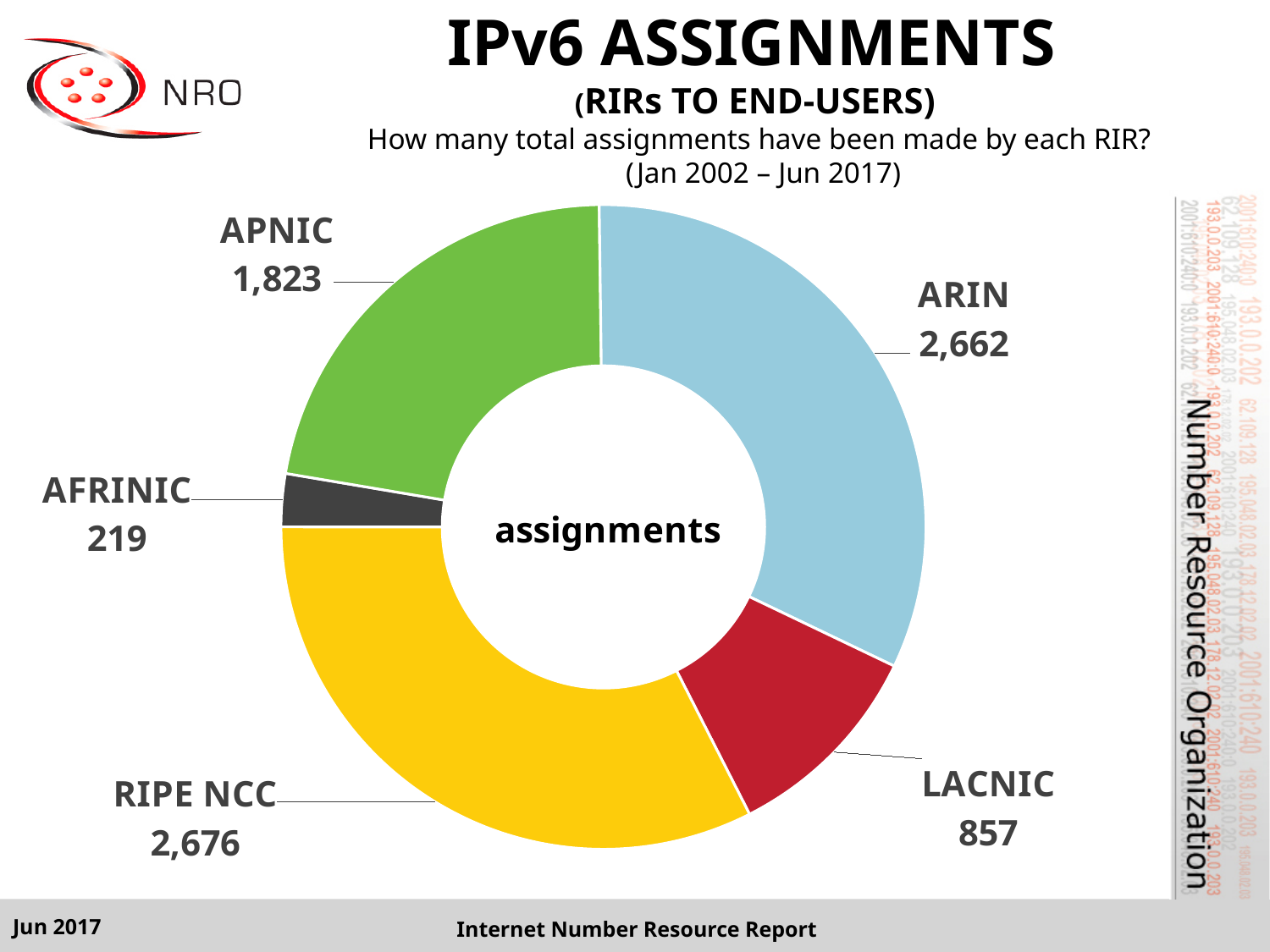
Which has more assignments, APNIC or LACNIC? APNIC How many IPv6 assignments has ARIN made according to the chart? 2,662 What is the difference between the assignments of ARIN and LACNIC? 1,805 How many assignments are shown for AFRINIC? 219 How many RIRs are shown as slices in the chart? 5 Which RIR has the fewest assignments in the chart? AFRINIC What is the value shown for APNIC? 1,823 What is the number of assignments shown for LACNIC? 857 What kind of chart is used on this slide? doughnut chart Which RIR has the most assignments in the chart? RIPE NCC What is the difference between the assignments of RIPE NCC and APNIC? 853 What value is shown for RIPE NCC? 2,676